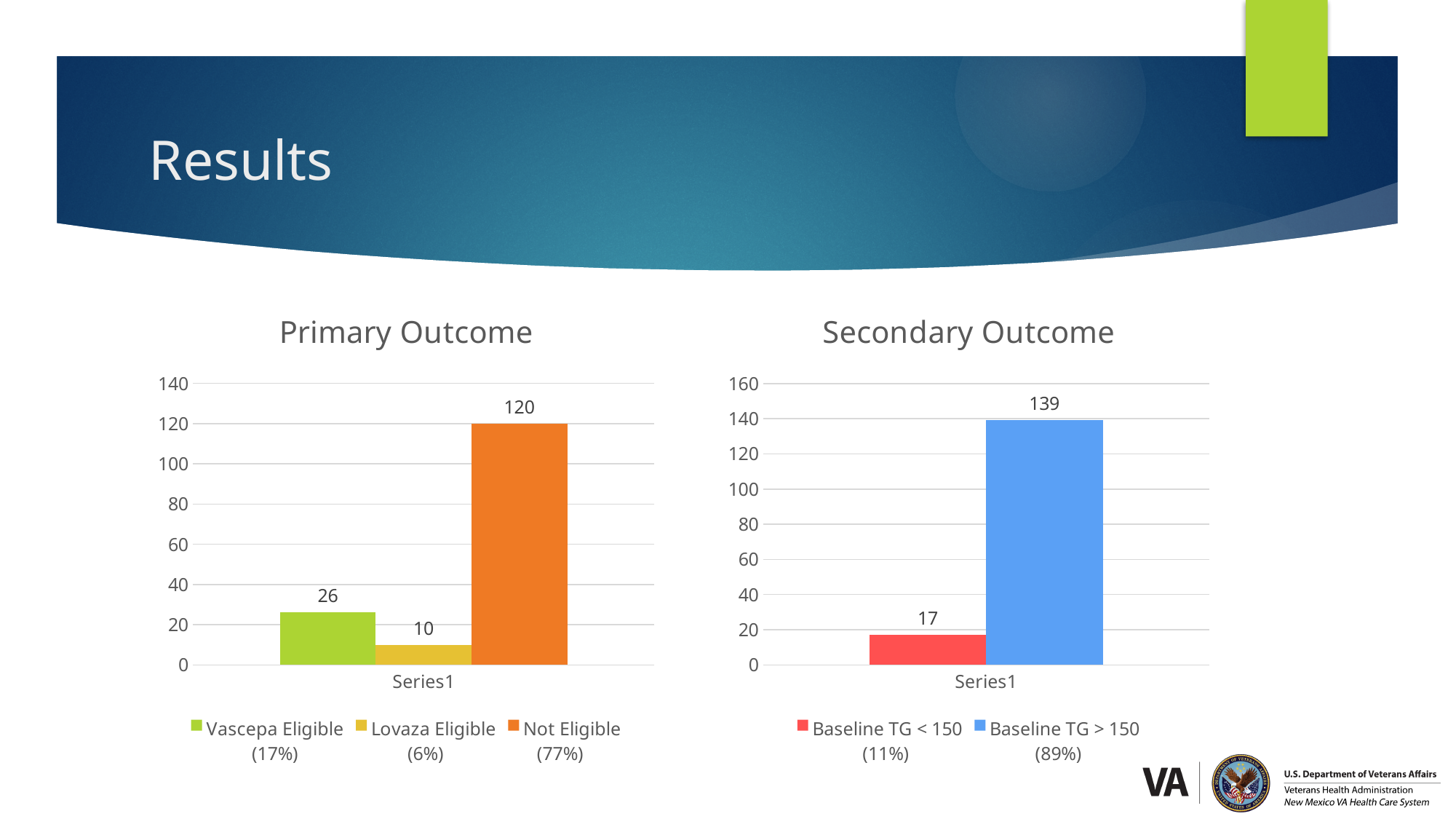
What kind of chart is the Secondary Outcome chart? Bar chart In the Primary Outcome chart, what is the value for Vascepa Eligible? 26 In the Primary Outcome chart, which series has the lowest value? Lovaza Eligible In the Secondary Outcome chart, which series has the highest value? Baseline TG > 150 In the Secondary Outcome chart, what is the value for Baseline TG > 150? 139 In the Primary Outcome chart, what percentage is shown in the legend for Lovaza Eligible? 6% In the Primary Outcome chart, what is the value for Not Eligible? 120 In the Primary Outcome chart, how many series does the legend list? 3 In the Secondary Outcome chart, what is the value for Baseline TG < 150? 17 In the Secondary Outcome chart, what is the difference between Baseline TG > 150 and Baseline TG < 150? 122 In the Secondary Outcome chart, what colour is the bar for Baseline TG < 150? Red In the Primary Outcome chart, what is the difference between Not Eligible and Vascepa Eligible? 94